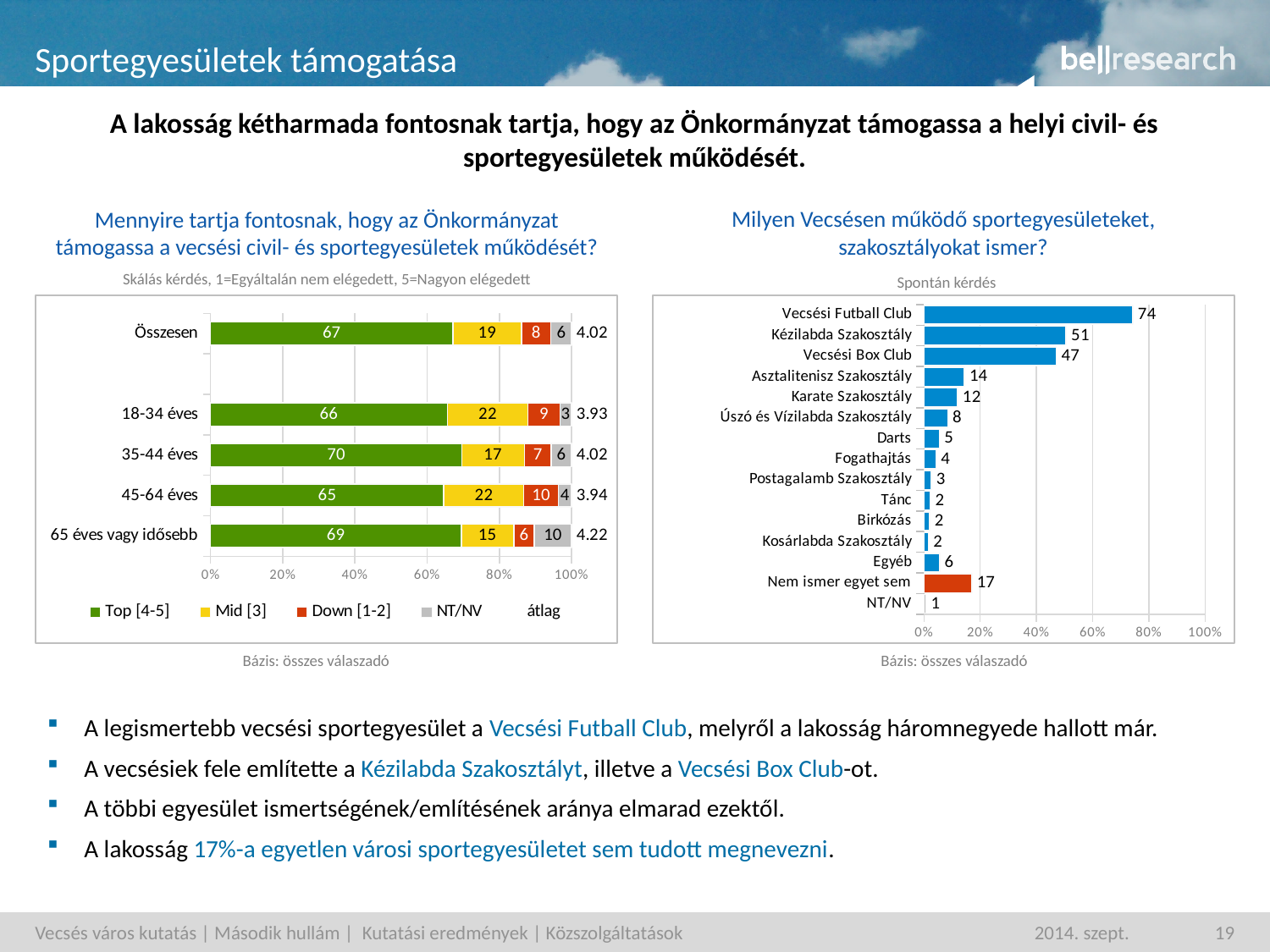
In the right chart, what is the difference between the values for Kézilabda Szakosztály and Vecsési Box Club? 4 What kind of chart is the left chart? Stacked bar chart In the left chart, which age group has the highest Top [4-5] value? 35-44 éves In the right chart ("Milyen Vecsésen működő sportegyesületeket, szakosztályokat ismer?"), what is the value for Vecsési Futball Club? 74 In the right chart, which is larger: the value for Asztalitenisz Szakosztály or the value for Karate Szakosztály? Asztalitenisz Szakosztály In the right chart, how many categories are plotted? 15 In the right chart, which category has the lowest value? NT/NV In the right chart, which category has the highest value? Vecsési Futball Club In the left chart, how many series does the legend list? 5 In the left chart ("Mennyire tartja fontosnak..."), what is the Top [4-5] value for Összesen? 67 In the left chart, what is the átlag (average) value for the 65 éves vagy idősebb group? 4.22 In the right chart, what is the value for Nem ismer egyet sem? 17